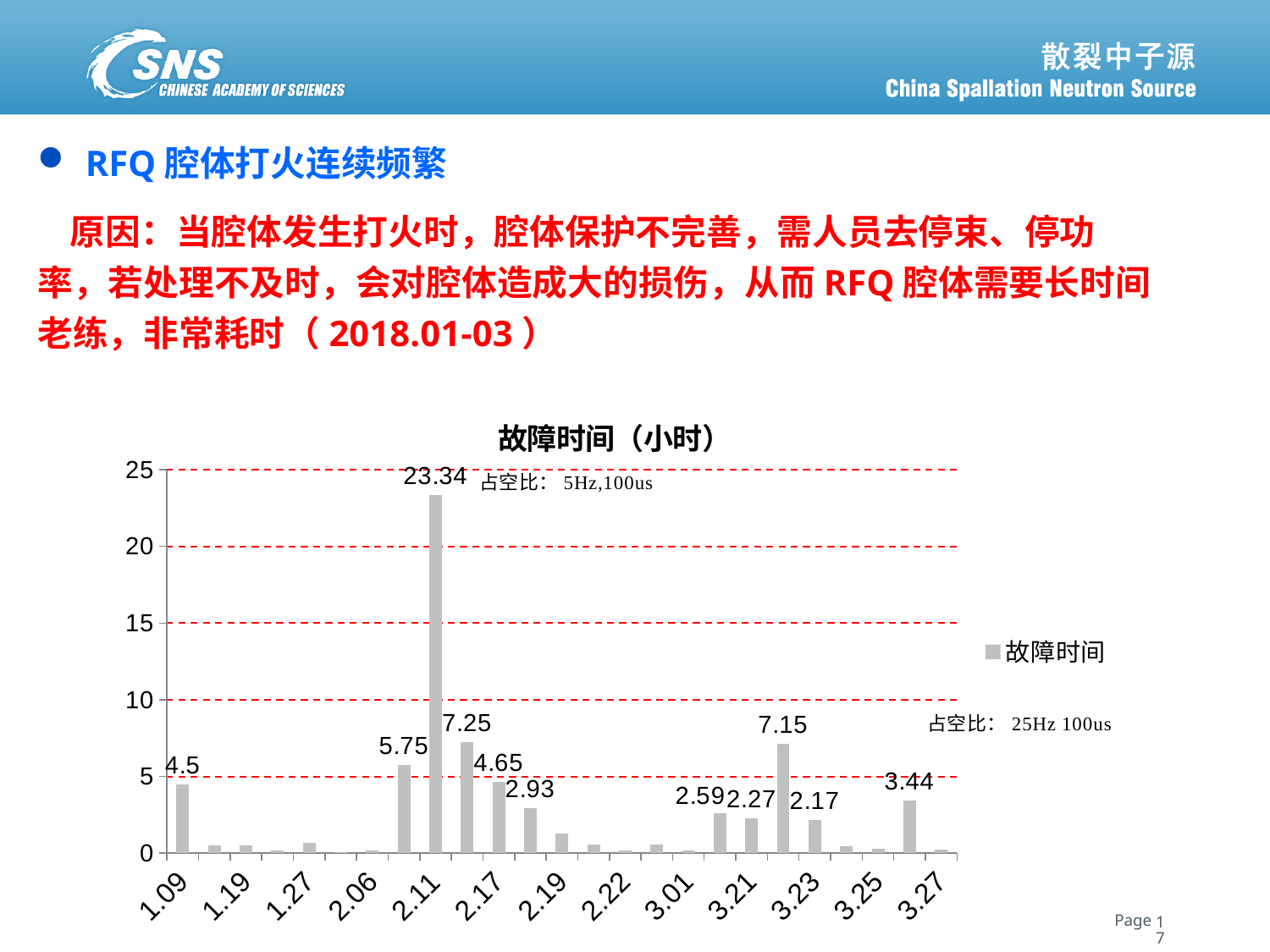
What kind of chart is shown on the slide? bar chart What is the title of the chart? 故障时间（小时） What is the difference between the labelled values 5.75 and 4.65? 1.1 Is the value of the tallest bar greater or less than 20? greater Which labelled value is larger, 7.25 or 7.15? 7.25 What is the maximum value shown on the y axis? 25 Is the value of the first bar (1.09) greater or less than 5? less How many series does the chart legend list? 1 What is the value of the first bar, at 1.09? 4.5 What is the difference between the highest labelled value (23.34) and the second highest labelled value (7.25)? 16.09 What is the highest value labelled on the chart? 23.34 What is the name of the series shown in the legend? 故障时间